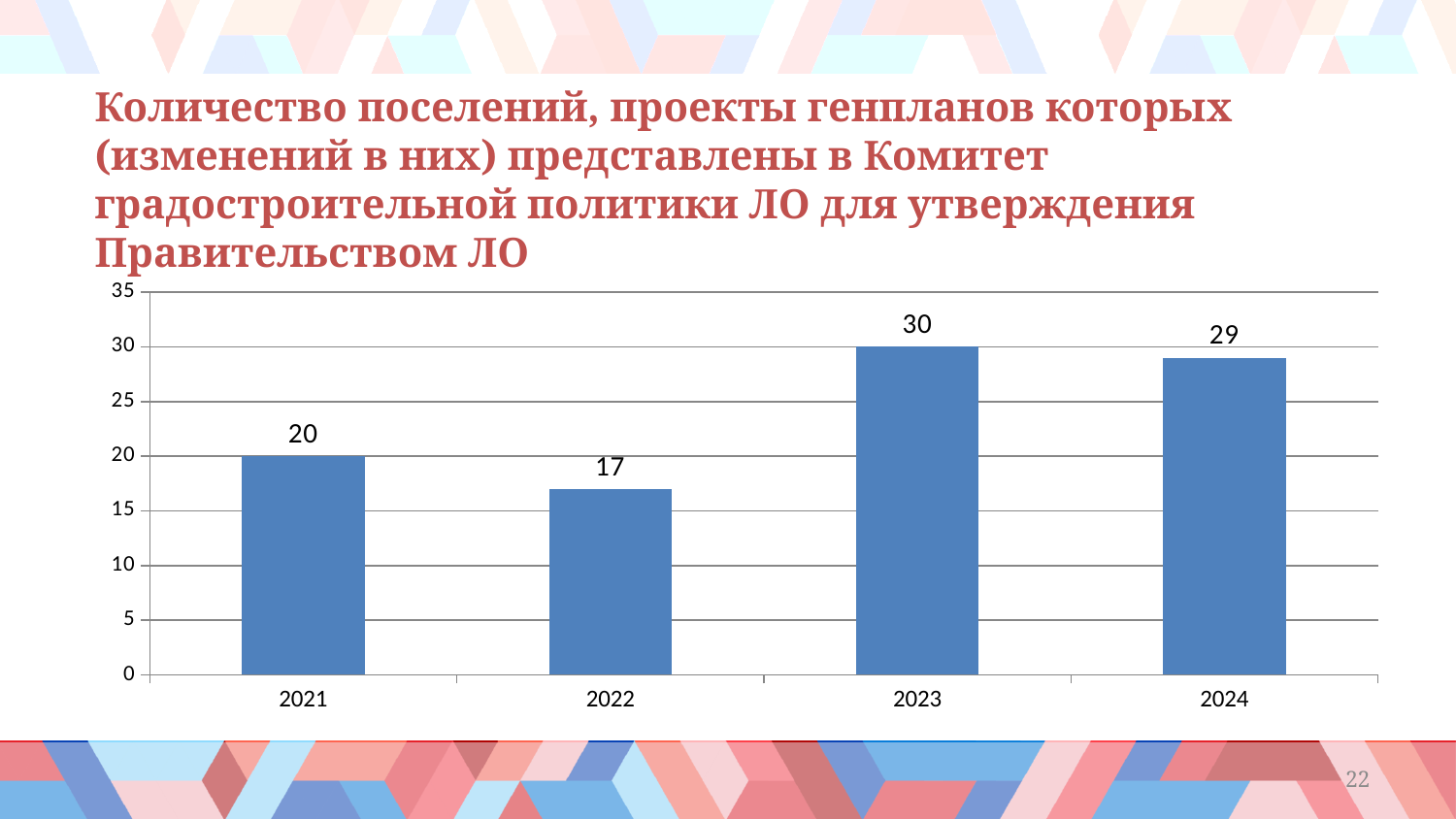
What is the value for 2022? 17 Which year has the highest value? 2023 Which is larger, the value for 2021 or the value for 2022? 2021 How many years are shown on the x axis? 4 What is the value for 2024? 29 Is the value for 2024 greater or less than 25? greater Which year has the lowest value? 2022 What is the value for 2021? 20 What is the difference between the values for 2023 and 2022? 13 Does the value rise or fall from 2022 to 2023? rise What kind of chart is shown on the slide? bar chart What is the value for 2023? 30